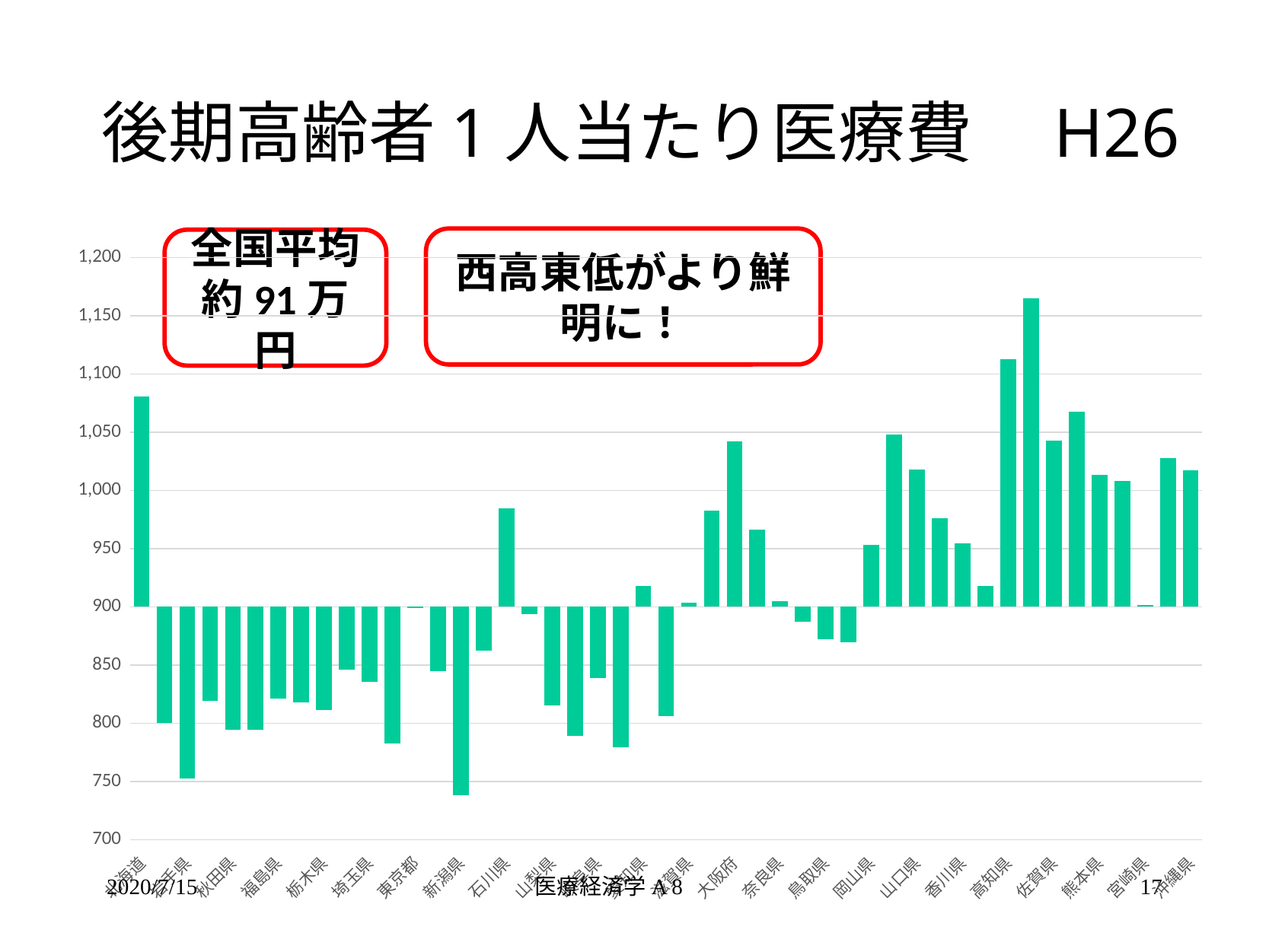
Is the value for 新潟県 greater or less than 800? less What kind of chart is shown on the slide? bar chart Which has the larger value, 北海道 or 新潟県? 北海道 Which labelled prefecture has the lowest value in the chart? 新潟県 Is the value for 秋田県 greater or less than 850? less Is the value for 東京都 greater or less than 850? greater Which has the larger value, 大阪府 or 東京都? 大阪府 According to the red annotation box, what is the national average (全国平均) stated on the slide? 約91万円